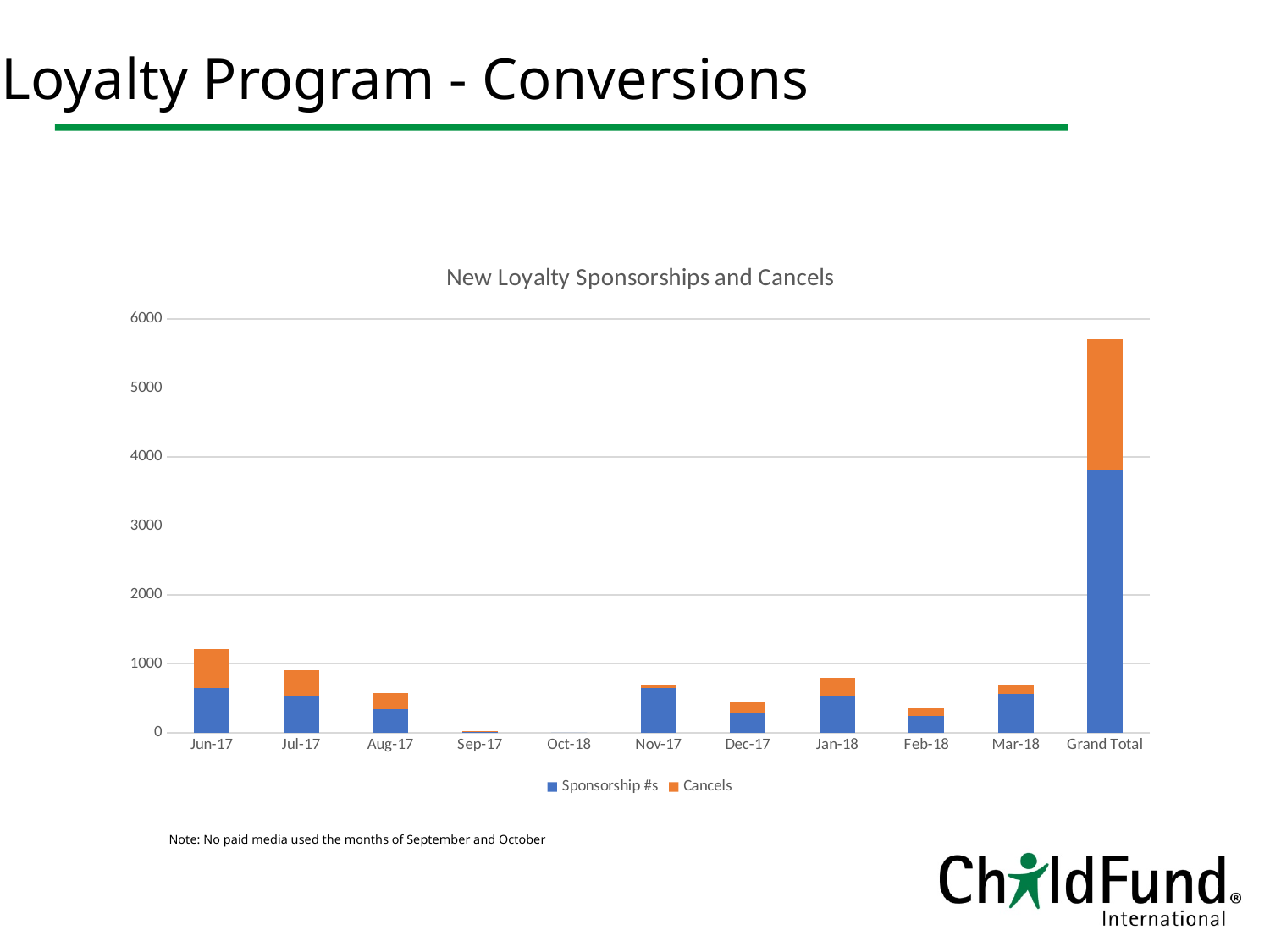
Which month has the smallest stacked bar? Oct-18 Which series is shown in orange? Cancels What kind of chart is shown on the slide? Stacked bar chart What is the title of the chart? New Loyalty Sponsorships and Cancels Is the total stacked value for Jun-17 greater or less than 1000? greater How many series does the legend list? 2 Is the Sponsorship #s value for Grand Total greater or less than 3000? greater Is the total stacked value for Grand Total greater or less than 5000? greater Which has the larger Sponsorship #s value, Nov-17 or Dec-17? Nov-17 Excluding Grand Total, which month has the tallest stacked bar? Jun-17 How many categories are shown on the x axis? 11